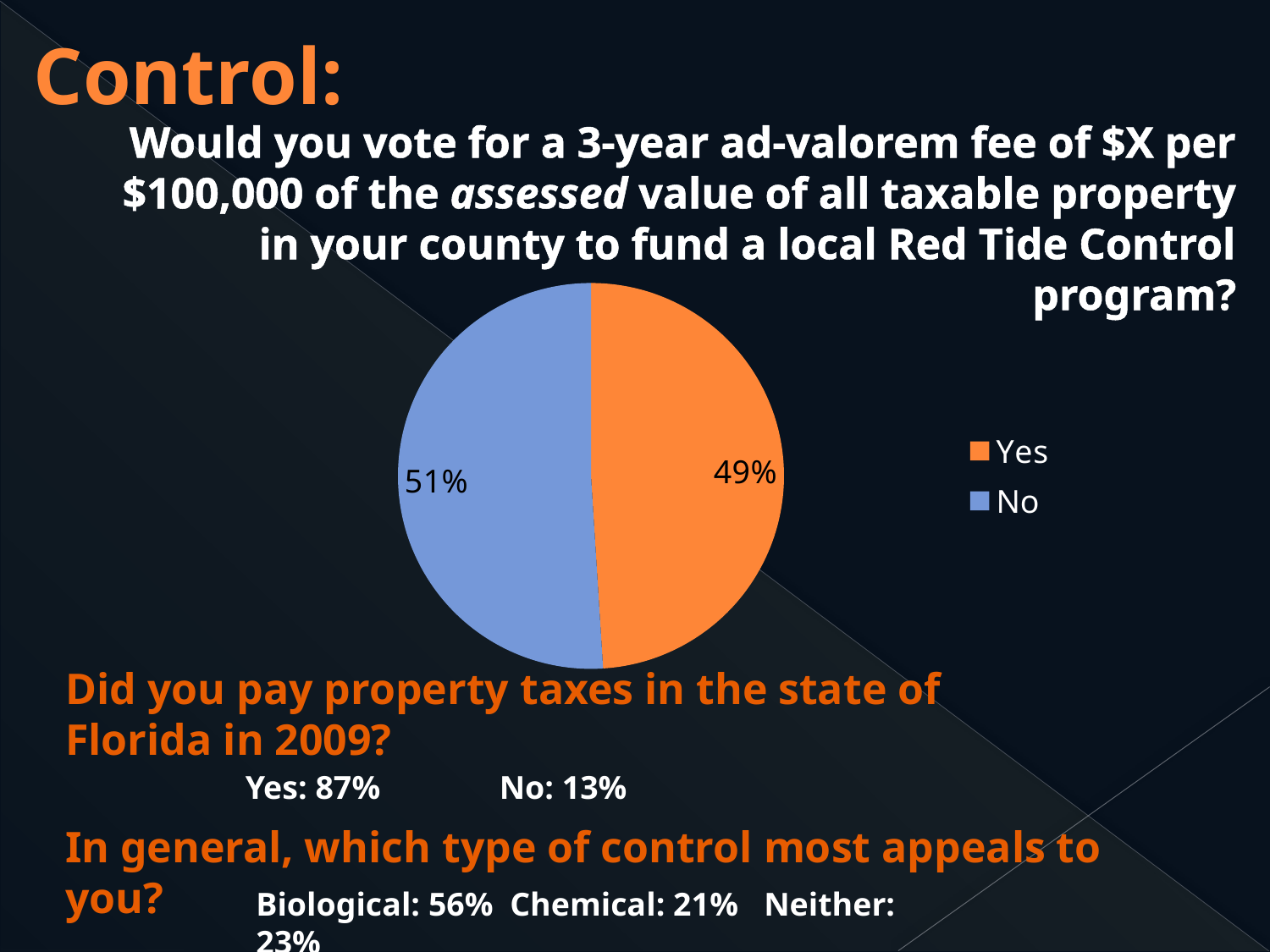
Which response has the larger share of the pie chart, Yes or No? No What colour is the Yes slice in the pie chart? orange How many slices does the pie chart have? 2 What percentage of respondents answered Yes in the pie chart? 49% What colour is the No slice in the pie chart? blue Which category has the smallest slice in the pie chart? Yes Is the share for Yes in the pie chart greater or less than 50%? less What is the difference in percentage points between the No and Yes slices of the pie chart? 2 Which category has the largest slice in the pie chart? No What percentage of respondents answered No in the pie chart? 51% How many entries does the pie chart's legend list? 2 What kind of chart is shown on the slide? pie chart